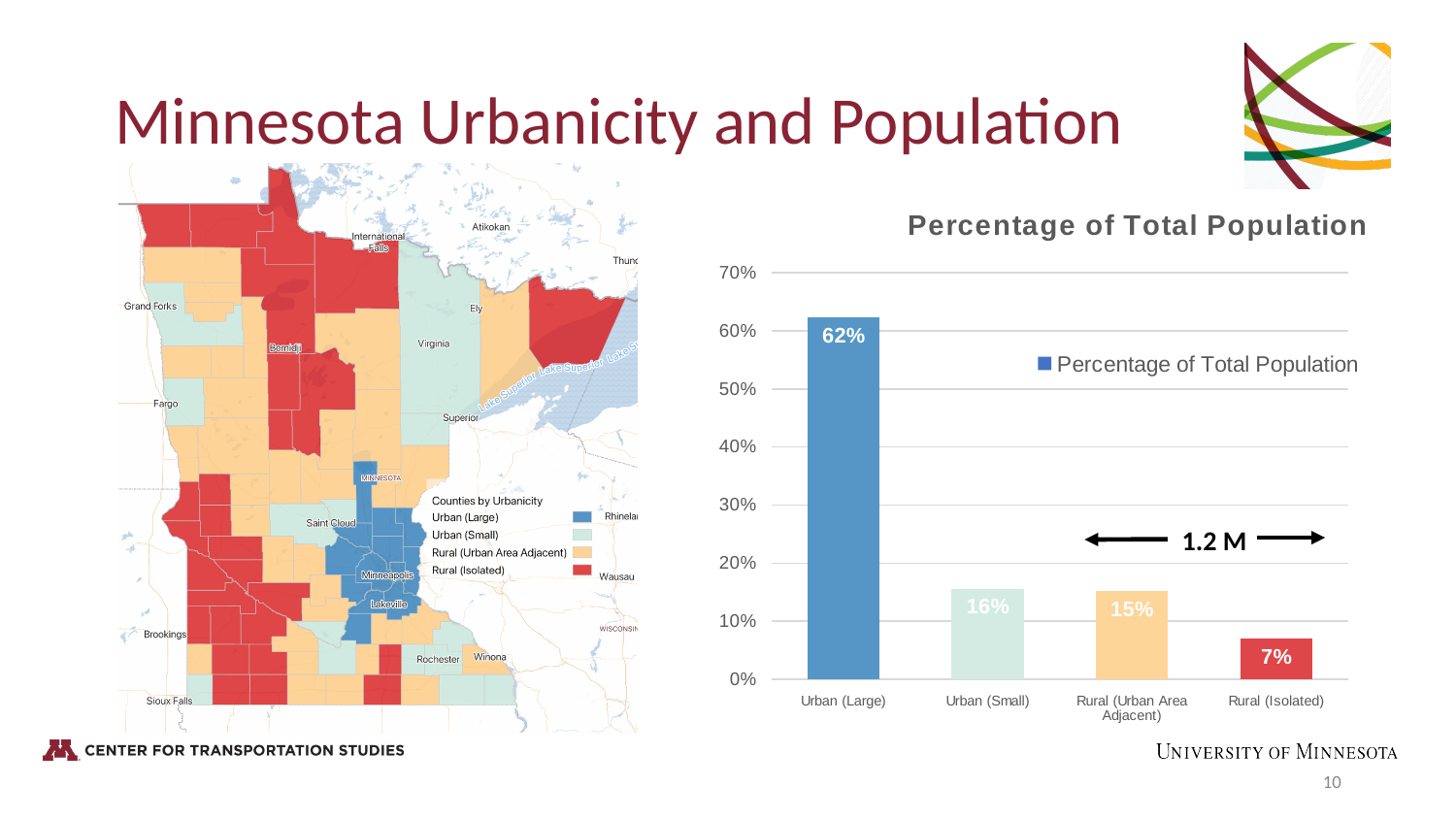
What is the value for Rural (Urban Area Adjacent) in the Percentage of Total Population chart? 15% How many categories are shown in the Percentage of Total Population chart? 4 Which category has the highest value in the Percentage of Total Population chart? Urban (Large) What kind of chart is the Percentage of Total Population chart? bar chart What is the value for Urban (Small) in the Percentage of Total Population chart? 16% What is the value for Rural (Isolated) in the Percentage of Total Population chart? 7% Which is larger in the Percentage of Total Population chart: Urban (Small) or Rural (Isolated)? Urban (Small) Which category has the lowest value in the Percentage of Total Population chart? Rural (Isolated) Is the value for Urban (Large) in the Percentage of Total Population chart greater or less than 50%? greater What is the difference between the Urban (Large) and Rural (Isolated) values in the Percentage of Total Population chart? 55% What is the value for Urban (Large) in the Percentage of Total Population chart? 62% What is the title of the chart on the right side of the slide? Percentage of Total Population